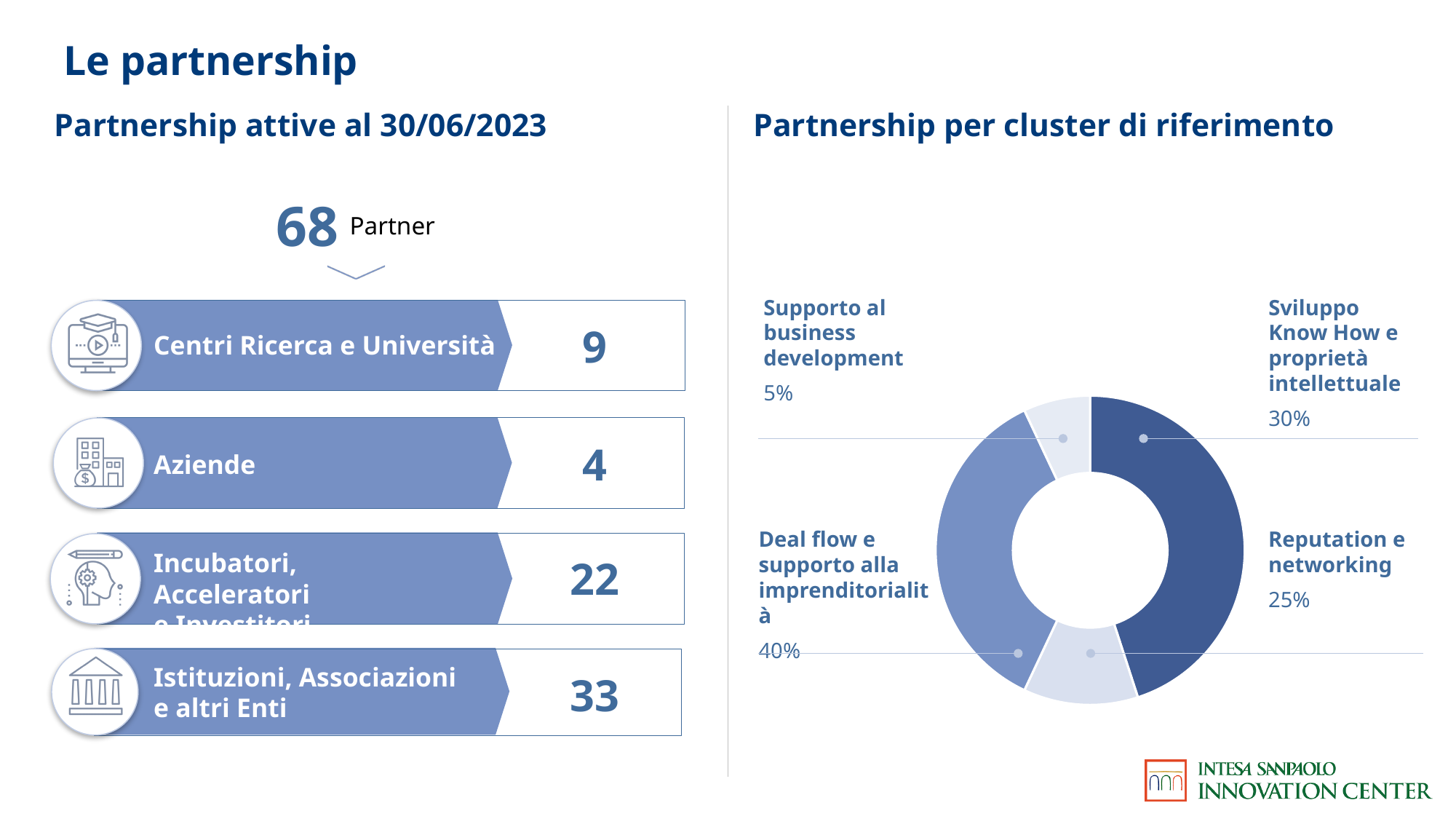
What kind of chart is 'Partnership per cluster di riferimento'? Donut chart In the 'Partnership per cluster di riferimento' chart, what share is shown for 'Sviluppo Know How e proprietà intellettuale'? 30% What is the title of the chart on the right side of the slide? Partnership per cluster di riferimento In the 'Partnership per cluster di riferimento' chart, what share is shown for 'Supporto al business development'? 5% In the 'Partnership per cluster di riferimento' chart, what is the combined share of 'Sviluppo Know How e proprietà intellettuale' and 'Reputation e networking'? 55% In the 'Partnership per cluster di riferimento' chart, which cluster has the largest share? Deal flow e supporto alla imprenditorialità In the 'Partnership per cluster di riferimento' chart, which cluster has the smallest share? Supporto al business development In the 'Partnership per cluster di riferimento' chart, what share is shown for 'Reputation e networking'? 25% In the 'Partnership per cluster di riferimento' chart, what share is shown for 'Deal flow e supporto alla imprenditorialità'? 40% In the 'Partnership per cluster di riferimento' chart, what is the difference in percentage points between 'Deal flow e supporto alla imprenditorialità' and 'Reputation e networking'? 15 percentage points How many clusters are shown in the 'Partnership per cluster di riferimento' chart? 4 In the 'Partnership per cluster di riferimento' chart, which has a larger share: 'Sviluppo Know How e proprietà intellettuale' or 'Reputation e networking'? Sviluppo Know How e proprietà intellettuale